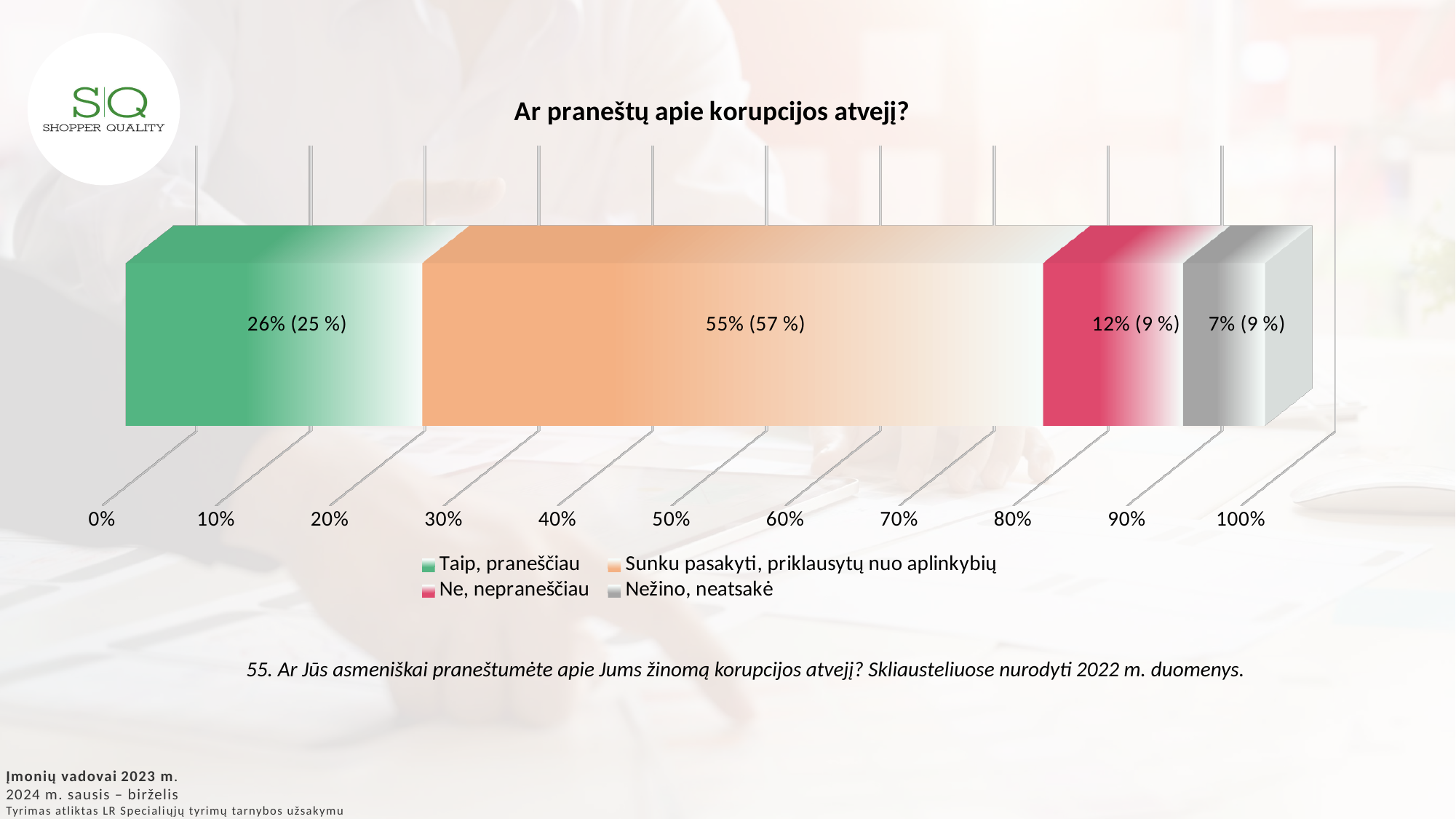
What is the 2023 value for "Sunku pasakyti, priklausytų nuo aplinkybių"? 55% What was the 2022 value (shown in brackets) for "Sunku pasakyti, priklausytų nuo aplinkybių"? 57 % What is the 2023 value for "Taip, praneščiau"? 26% How many series does the legend list? 4 What is the 2023 value for "Ne, nepraneščiau"? 12% What kind of chart is shown on the slide? Stacked bar chart Which response category has the highest 2023 value? Sunku pasakyti, priklausytų nuo aplinkybių Which is larger in 2023: "Taip, praneščiau" or "Ne, nepraneščiau"? Taip, praneščiau What is the title of the chart? Ar praneštų apie korupcijos atvejį? What is the difference between the 2023 values for "Sunku pasakyti, priklausytų nuo aplinkybių" and "Taip, praneščiau"? 29% What is the 2023 value for "Nežino, neatsakė"? 7% Which response category has the lowest 2023 value? Nežino, neatsakė